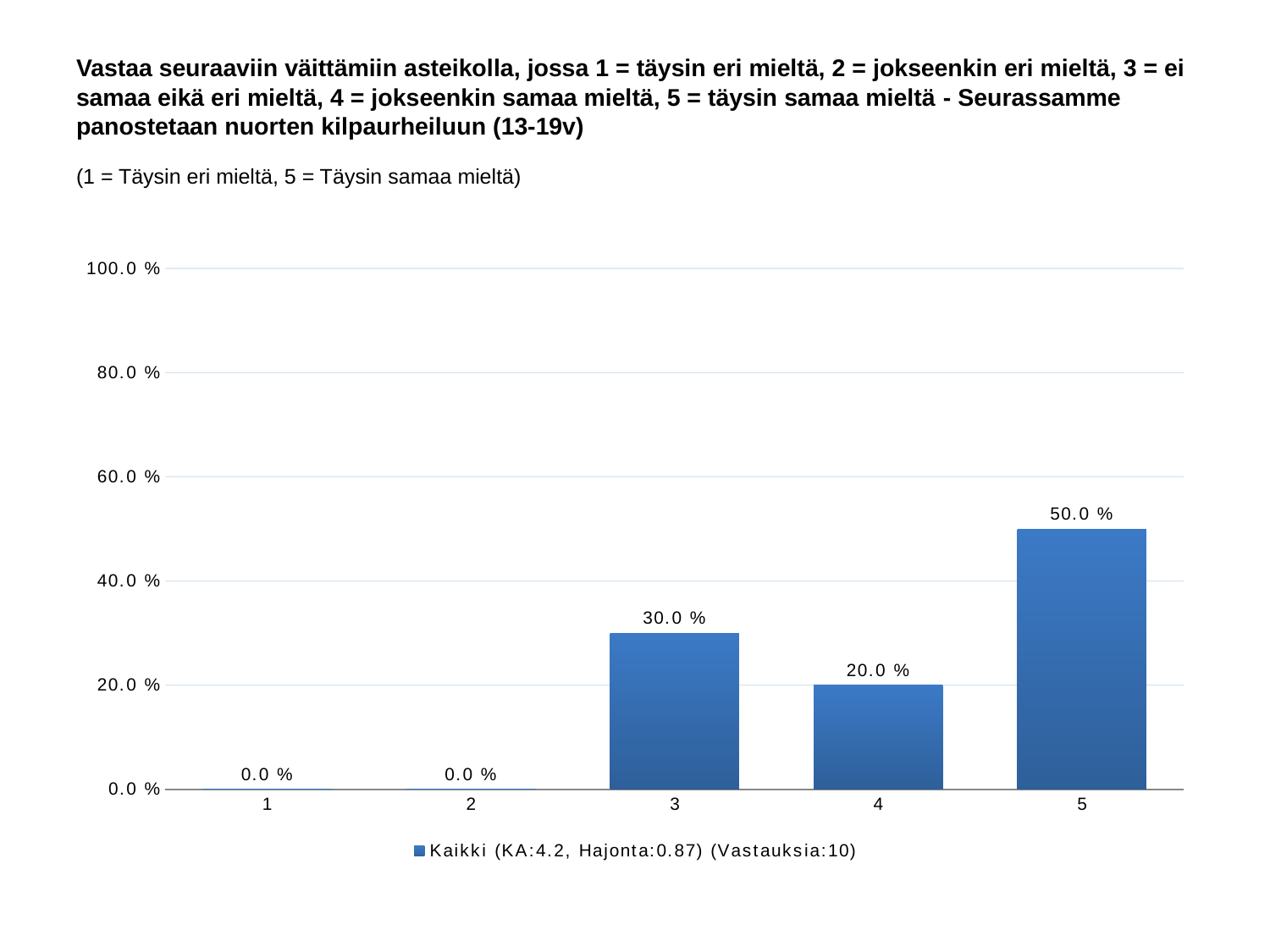
How many series does the legend list? 1 How many categories are shown on the x axis? 5 What is the legend entry for the series? Kaikki (KA:4.2, Hajonta:0.87) (Vastauksia:10) What is the value for category 3? 30.0 % What is the difference between the values for category 5 and category 3? 20.0 % What is the value for category 1? 0.0 % Is the value for category 5 greater or less than 40.0 %? greater What is the value for category 4? 20.0 % Which is larger, the value for category 3 or category 4? 3 Which category has the highest value? 5 What is the value for category 5? 50.0 % What kind of chart is shown? bar chart